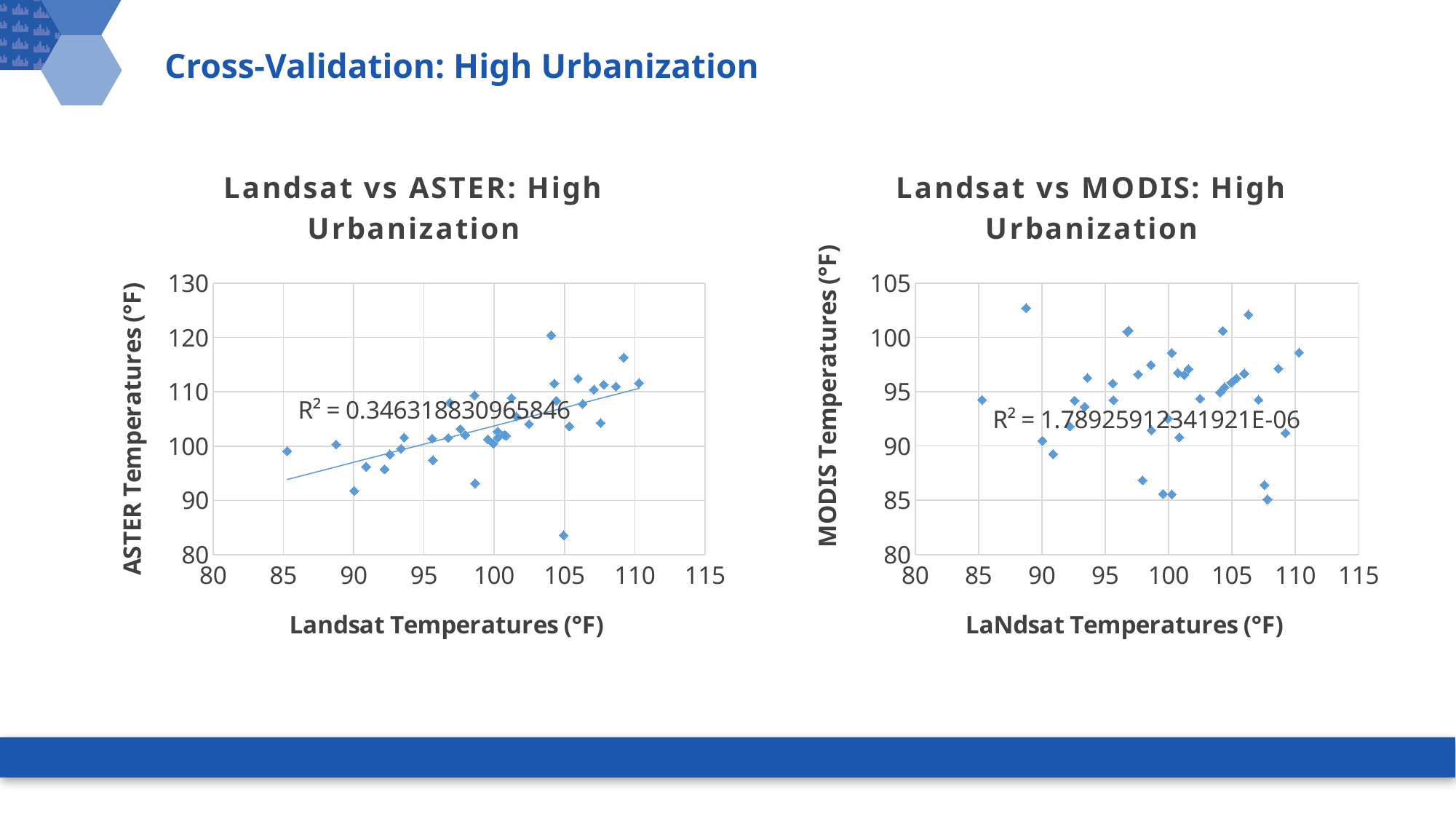
Which chart has the higher printed R² value, "Landsat vs ASTER: High Urbanization" or "Landsat vs MODIS: High Urbanization"? Landsat vs ASTER: High Urbanization What is the y-axis title of the "Landsat vs ASTER: High Urbanization" chart? ASTER Temperatures (°F) In the "Landsat vs ASTER: High Urbanization" chart, does the trendline rise or fall as Landsat temperature increases? rise What is the maximum value shown on the y-axis of the "Landsat vs MODIS: High Urbanization" chart? 105 What kind of chart is the "Landsat vs ASTER: High Urbanization" chart? scatter chart In the "Landsat vs MODIS: High Urbanization" chart, is the highest plotted MODIS temperature greater or less than 100? greater In the "Landsat vs MODIS: High Urbanization" chart, what R² value is printed on the chart? R² = 1.78925912341921E-06 In the "Landsat vs ASTER: High Urbanization" chart, what R² value is printed on the chart? R² = 0.346318830965846 What kind of chart is the "Landsat vs MODIS: High Urbanization" chart? scatter chart In the "Landsat vs MODIS: High Urbanization" chart, is the lowest plotted MODIS temperature greater or less than 90? less In the "Landsat vs ASTER: High Urbanization" chart, is the lowest plotted ASTER temperature greater or less than 90? less